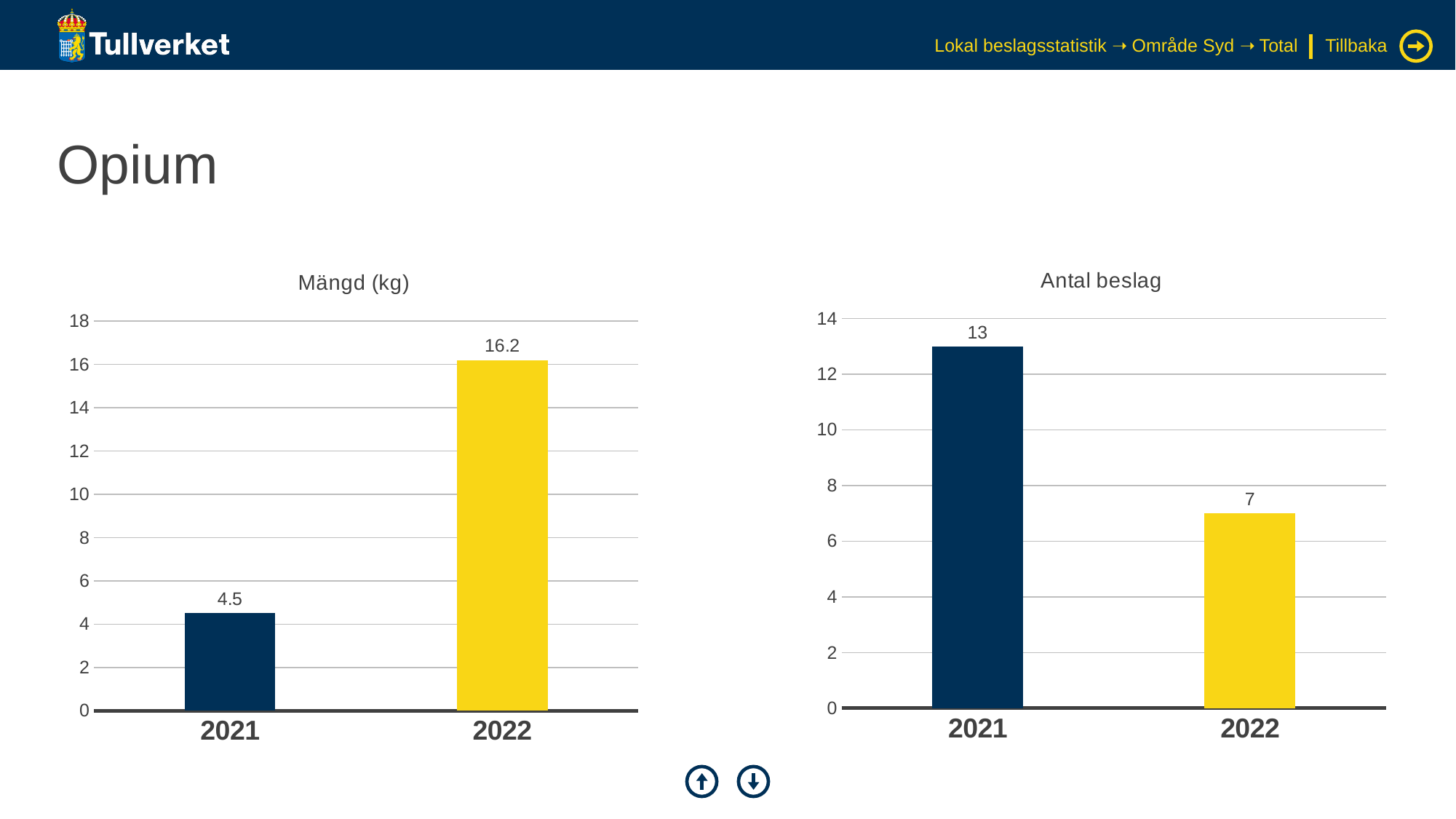
In the 'Antal beslag' chart, what is the value for 2021? 13 How many categories does the 'Antal beslag' chart show? 2 In the 'Antal beslag' chart, what is the value for 2022? 7 What kind of chart is the 'Mängd (kg)' chart? bar chart In the 'Antal beslag' chart, is the value for 2021 greater or less than 10? greater In the 'Mängd (kg)' chart, do the values rise or fall from 2021 to 2022? rise In the 'Antal beslag' chart, which year has the lowest value? 2022 In the 'Antal beslag' chart, what is the difference between the 2021 and 2022 values? 6 In the 'Mängd (kg)' chart, what is the value for 2022? 16.2 In the 'Mängd (kg)' chart, what is the difference between the 2022 and 2021 values? 11.7 In the 'Mängd (kg)' chart, which year has the highest value? 2022 In the 'Mängd (kg)' chart, what is the value for 2021? 4.5